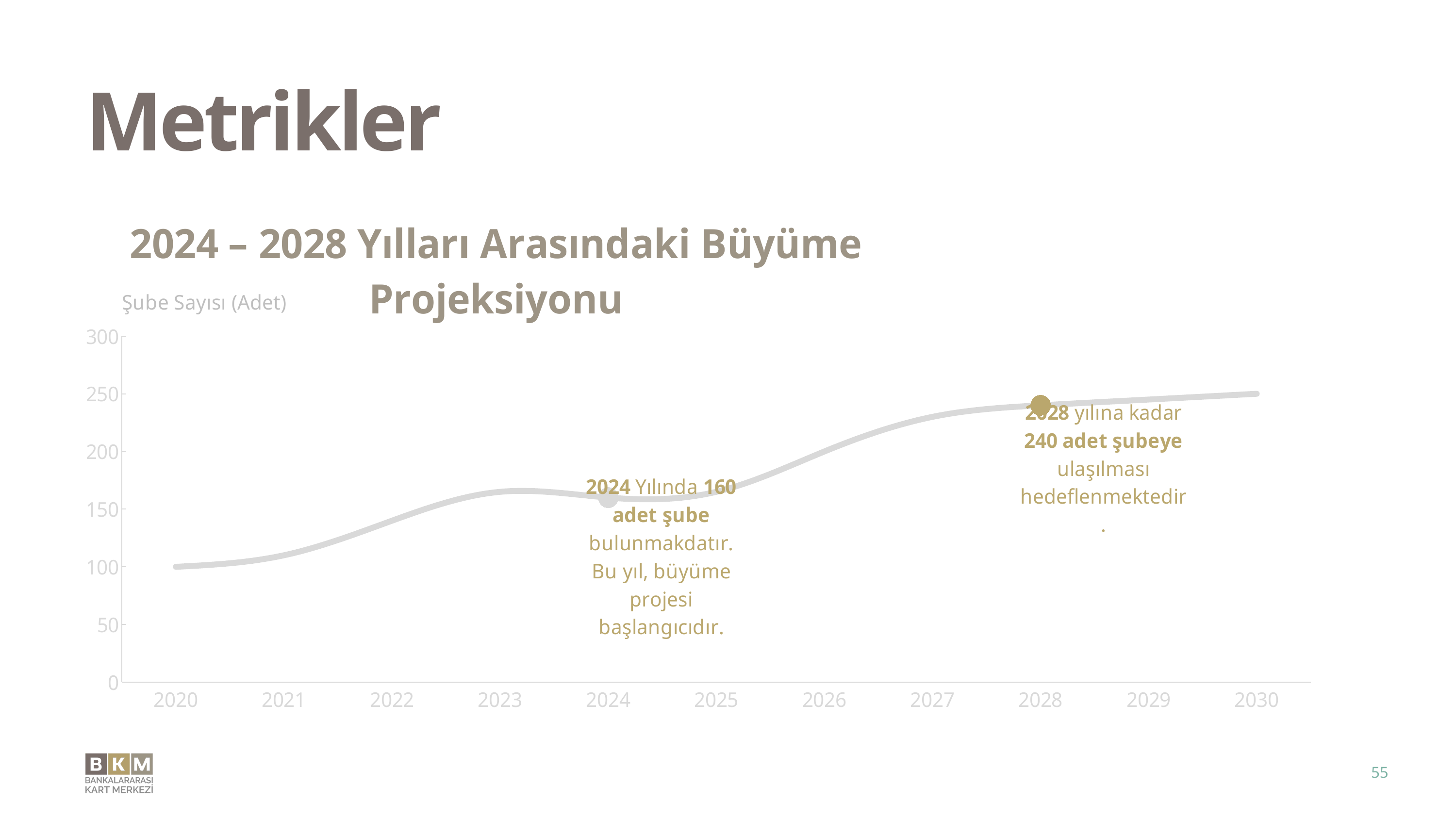
Which year has the lowest value on the chart? 2020 Is the value for 2026 greater or less than 150? greater What is the number of branches (şube sayısı) in 2024 according to the annotation? 160 How many years are shown on the x axis? 11 Does the line generally rise or fall from 2020 to 2030? rise What is the label of the y axis? Şube Sayısı (Adet) What is the difference between the 2028 target and the 2024 branch count? 80 What is the value for 2020 on the chart? 100 Is the value for 2022 greater or less than 150? less Which year has a higher value, 2024 or 2028? 2028 What is the targeted number of branches by 2028 according to the annotation? 240 What kind of chart is shown on the slide? line chart